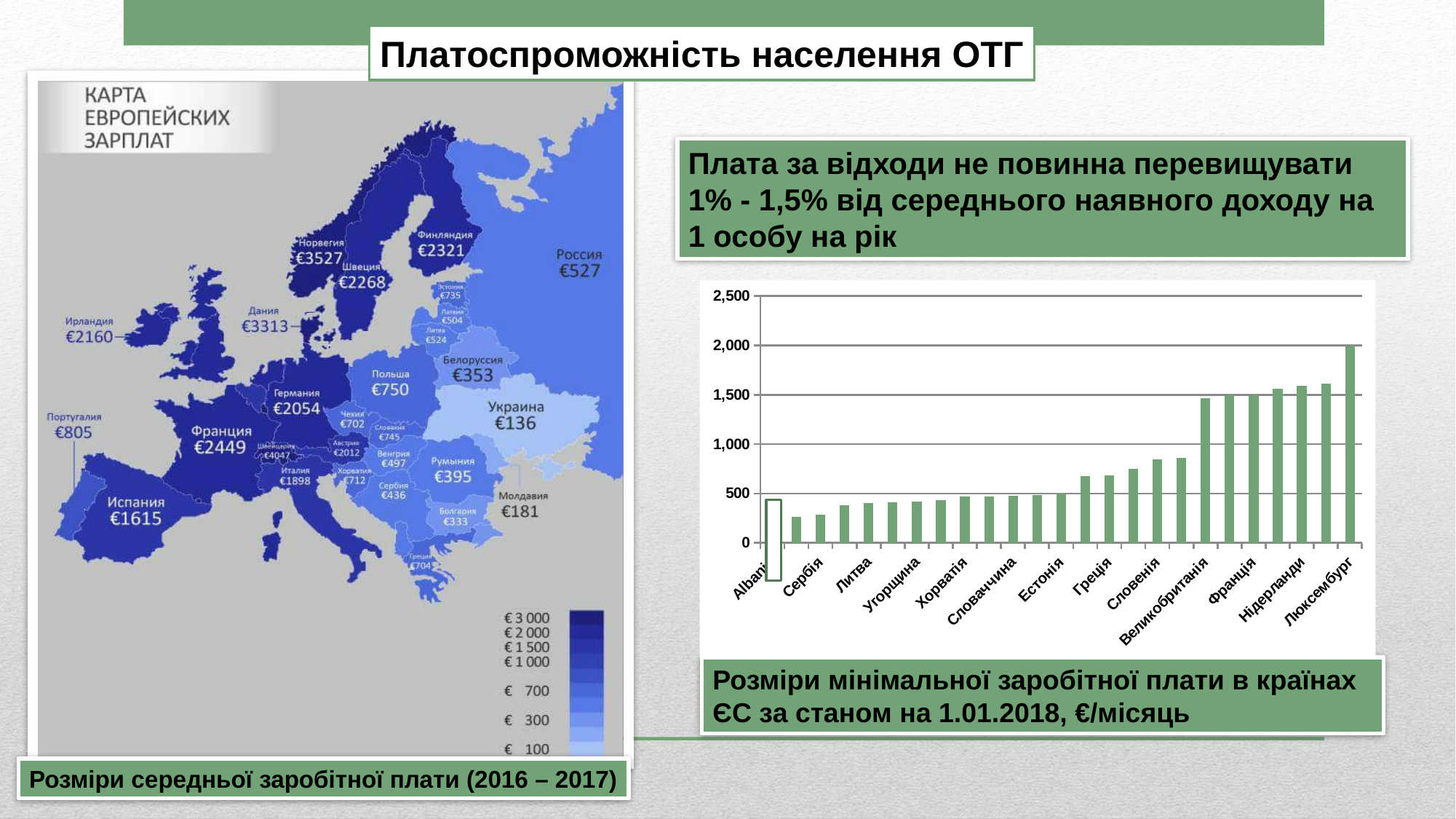
In the bar chart on the right, which is larger, the value for Люксембург or the value for Литва? Люксембург What kind of chart is shown on the right side of the slide? bar chart In the bar chart on the right, is the value for Сербія greater or less than 500? less In the bar chart on the right, what is the highest value shown on the vertical axis? 2,500 In the bar chart on the right, do the values rise or fall from left to right along the x axis? rise In the bar chart on the right, is the value for Великобританія greater or less than 1,000? greater According to the caption under the bar chart on the right, in what unit are the minimum wages given? €/місяць In the bar chart on the right, which country has the highest minimum wage? Люксембург In the bar chart on the right, is the value for Греція greater or less than 500? greater On the map on the left, what average salary is shown for Украина? €136